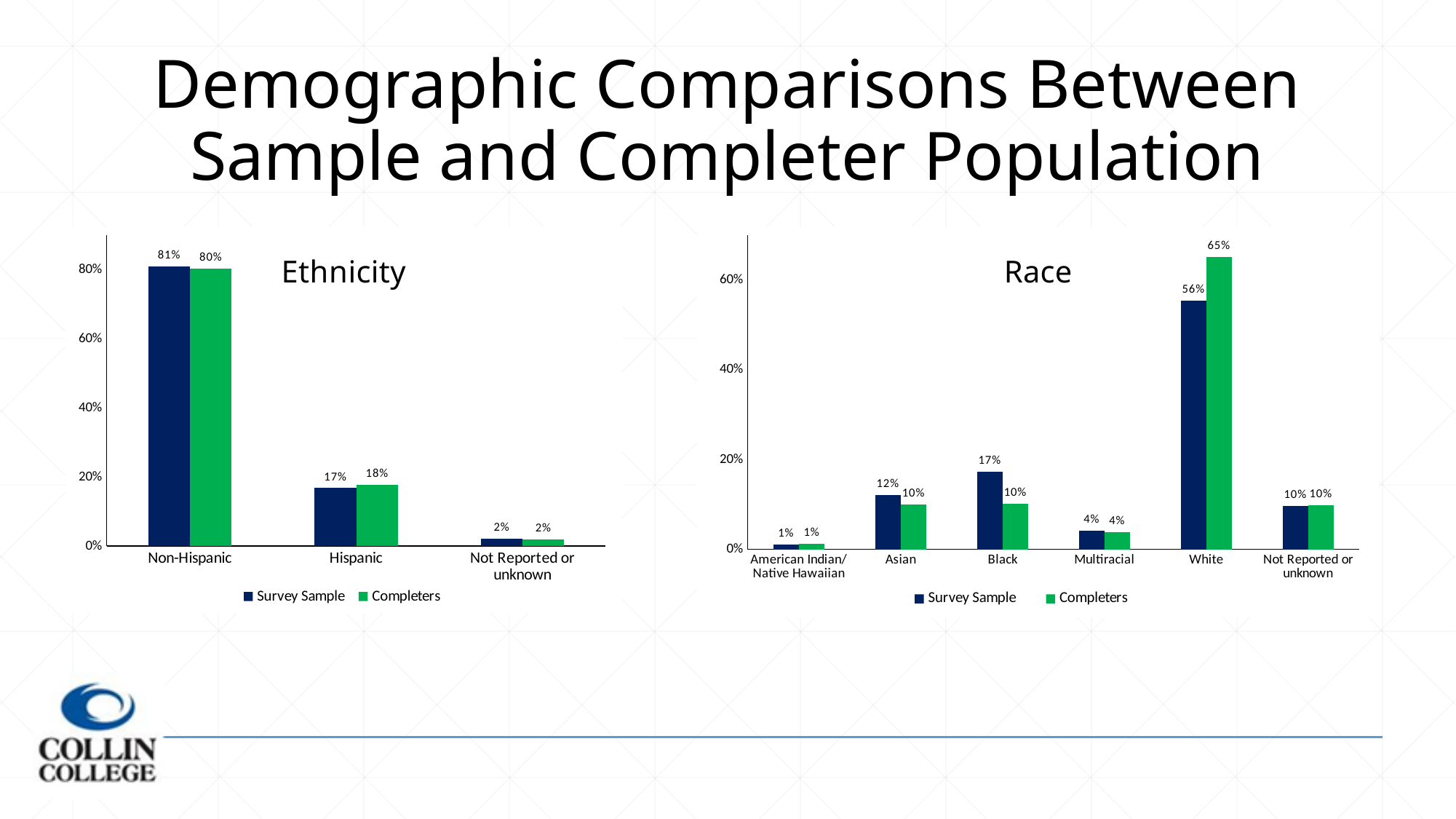
In the Ethnicity chart, what is the Completers value for Hispanic? 18% In the Race chart, which category has the lowest Completers value? American Indian/Native Hawaiian In the Ethnicity chart, what is the Survey Sample value for Non-Hispanic? 81% In the Race chart, which is larger for Asian: the Survey Sample value or the Completers value? Survey Sample In the Race chart, which category has the highest Survey Sample value? White How many series does the legend of the Ethnicity chart list? 2 In the Race chart, what is the difference between the Completers and Survey Sample values for White? 9% How many categories are shown on the x axis of the Race chart? 6 In the Race chart, what is the Survey Sample value for Black? 17% In the Ethnicity chart, what is the difference between the Survey Sample and Completers values for Non-Hispanic? 1% What kind of chart is the Ethnicity chart? Bar chart In the Race chart, what is the Completers value for White? 65%